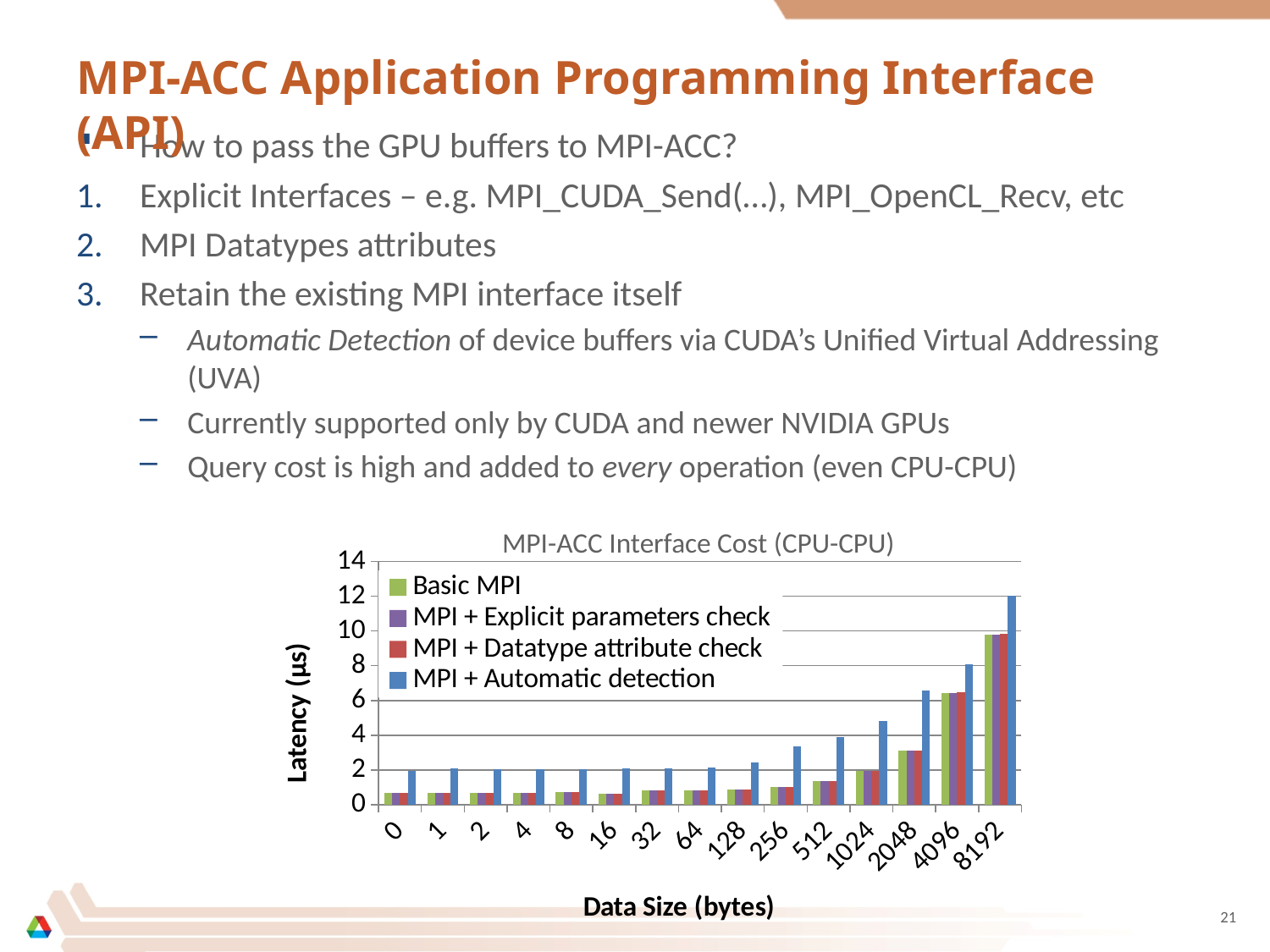
Which series has the highest latency at data size 8192? MPI + Automatic detection Is the latency for Basic MPI at data size 4096 greater or less than 4? greater Is the latency for MPI + Automatic detection at data size 8192 greater or less than 10? greater Do the latency values for Basic MPI rise or fall as data size increases along the x axis? rise What is the label of the y axis? Latency (µs) What is the title of the chart? MPI-ACC Interface Cost (CPU-CPU) At data size 2048, which is larger: the latency for MPI + Automatic detection or for Basic MPI? MPI + Automatic detection Is the latency for Basic MPI at data size 0 greater or less than 2? less How many data size categories are shown on the x axis? 15 What kind of chart is shown on the slide? bar chart How many series does the chart's legend list? 4